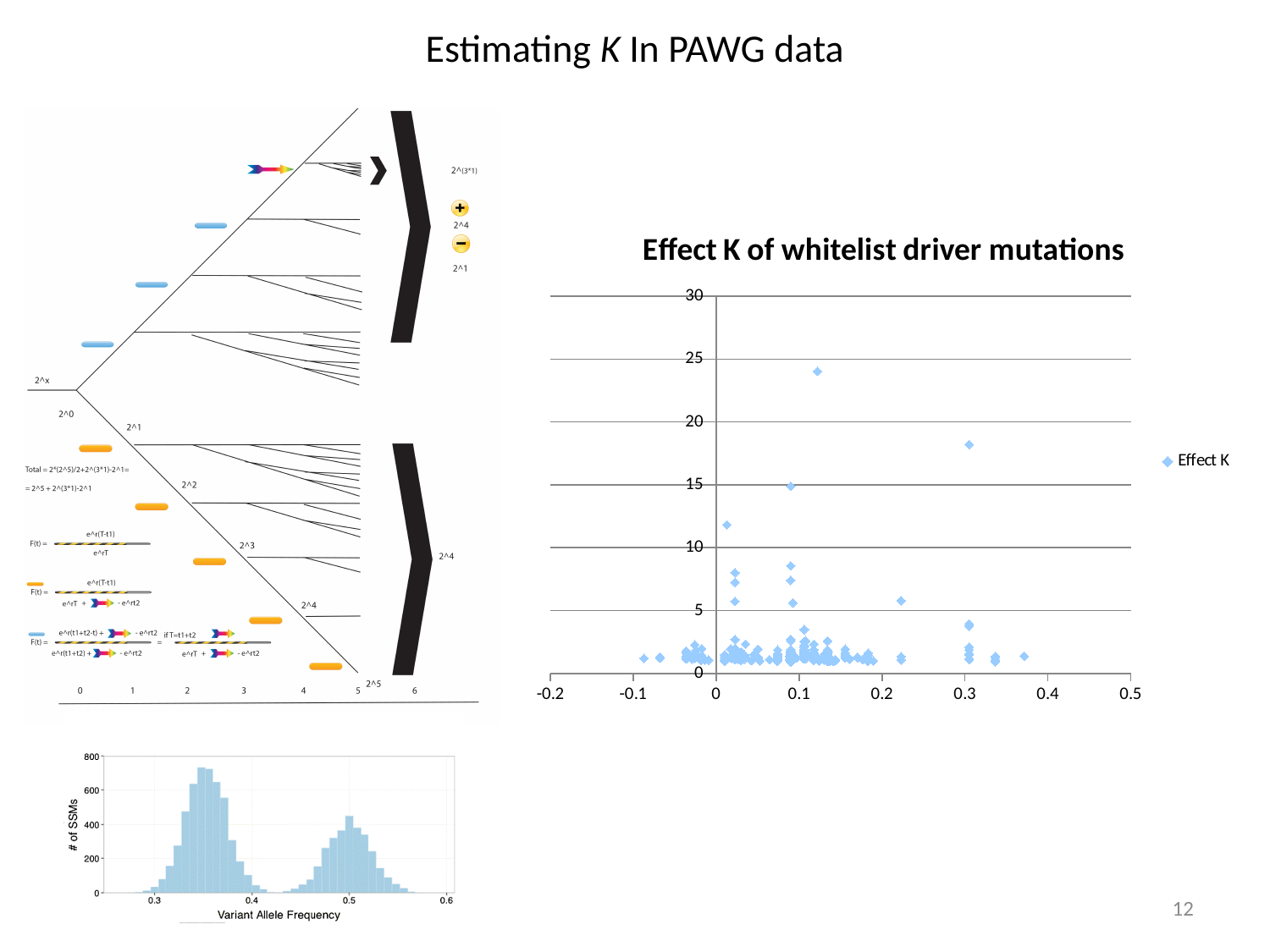
In the chart titled "Effect K of whitelist driver mutations", is the highest Effect K value greater or less than 20? greater In the chart titled "Effect K of whitelist driver mutations", is the Effect K value of the point near x = 0.3 that lies well above the cluster greater or less than 15? greater In the chart titled "Effect K of whitelist driver mutations", is the Effect K value of the isolated point near x = 0.01 greater or less than 10? greater In the chart titled "Effect K of whitelist driver mutations", which is larger: the highest point near x = 0.1 or the highest point near x = 0.3? the point near x = 0.1 In the chart titled "Effect K of whitelist driver mutations", how many series does the legend list? 1 In the chart titled "Effect K of whitelist driver mutations", what is the maximum value shown on the vertical axis? 30 In the chart titled "Effect K of whitelist driver mutations", what kind of chart is it? scatter chart In the chart at the bottom left of the slide (Variant Allele Frequency), which peak is higher: the one near 0.35 or the one near 0.5? the one near 0.35 In the chart titled "Effect K of whitelist driver mutations", what is the name of the series shown in the legend? Effect K In the chart at the bottom left of the slide (Variant Allele Frequency), what kind of chart is it? bar chart